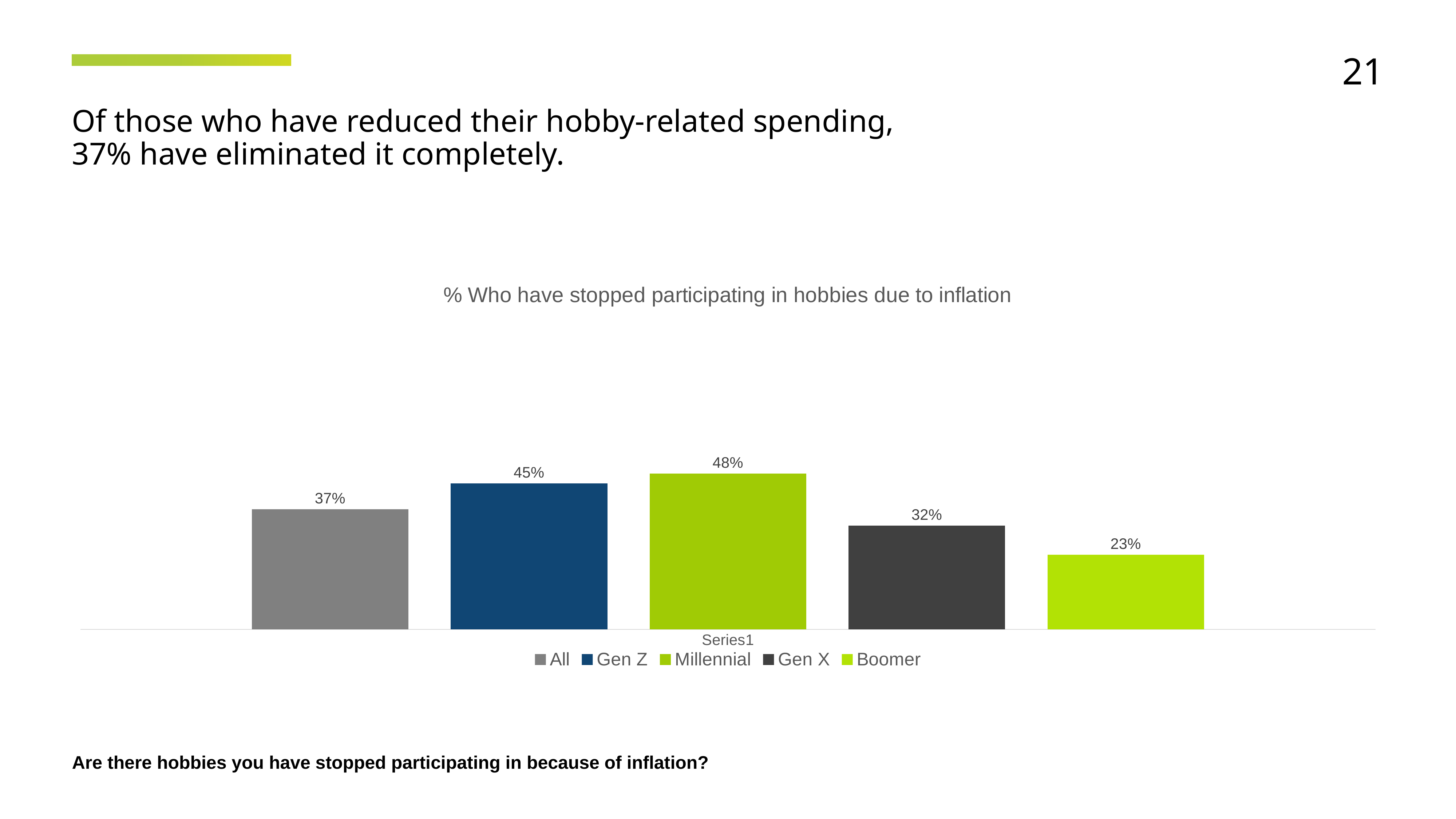
What is the value for Gen Z in the chart? 45% What is the difference between the Millennial value and the Boomer value? 25% What kind of chart is shown on the slide? Bar chart What is the title of the chart? % Who have stopped participating in hobbies due to inflation Which group has the highest percentage who have stopped participating in hobbies due to inflation? Millennial Which is larger, the value for Gen Z or the value for All? Gen Z Which group has the lowest percentage who have stopped participating in hobbies due to inflation? Boomer What is the value for All in the chart? 37% How many series does the legend list? 5 What is the value for Gen X in the chart? 32% What is the difference between the Gen Z value and the Gen X value? 13% What is the value for Boomer in the chart? 23%